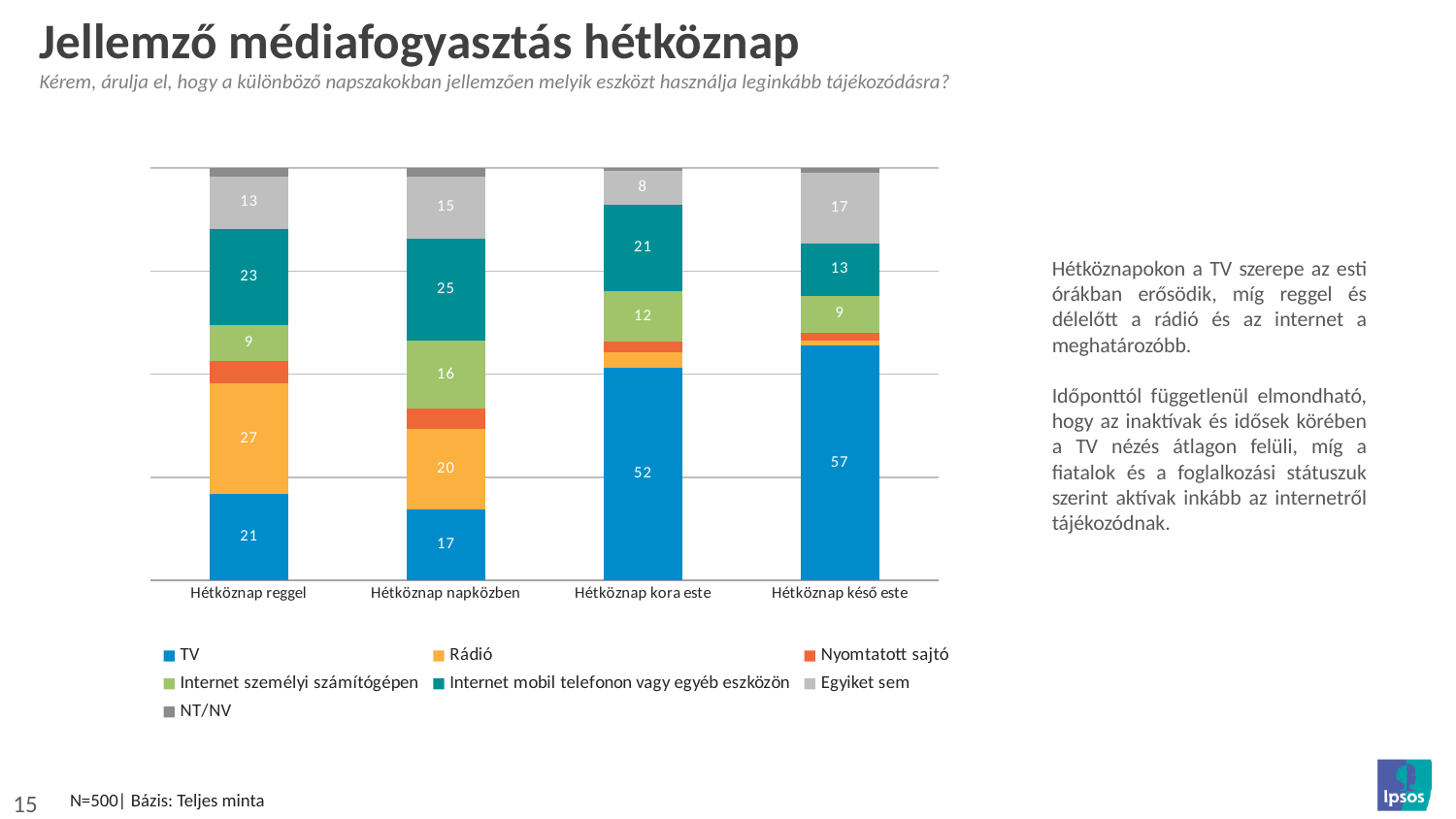
What is the value for Rádió in the Hétköznap reggel bar? 27 In which category is the TV value lowest? Hétköznap napközben In which category is the TV value highest? Hétköznap késő este What is the difference between the TV value for Hétköznap késő este and Hétköznap reggel? 36 What is the value for Egyiket sem in the Hétköznap kora este bar? 8 What is the value for TV in the Hétköznap késő este bar? 57 Does the TV value rise or fall from Hétköznap napközben to Hétköznap késő este? Rise How many categories are shown on the x axis? 4 Which has the larger Internet mobil telefonon vagy egyéb eszközön value: Hétköznap reggel or Hétköznap napközben? Hétköznap napközben What kind of chart is shown on the slide? Stacked bar chart What is the value for Internet személyi számítógépen in the Hétköznap napközben bar? 16 How many series does the legend list? 7